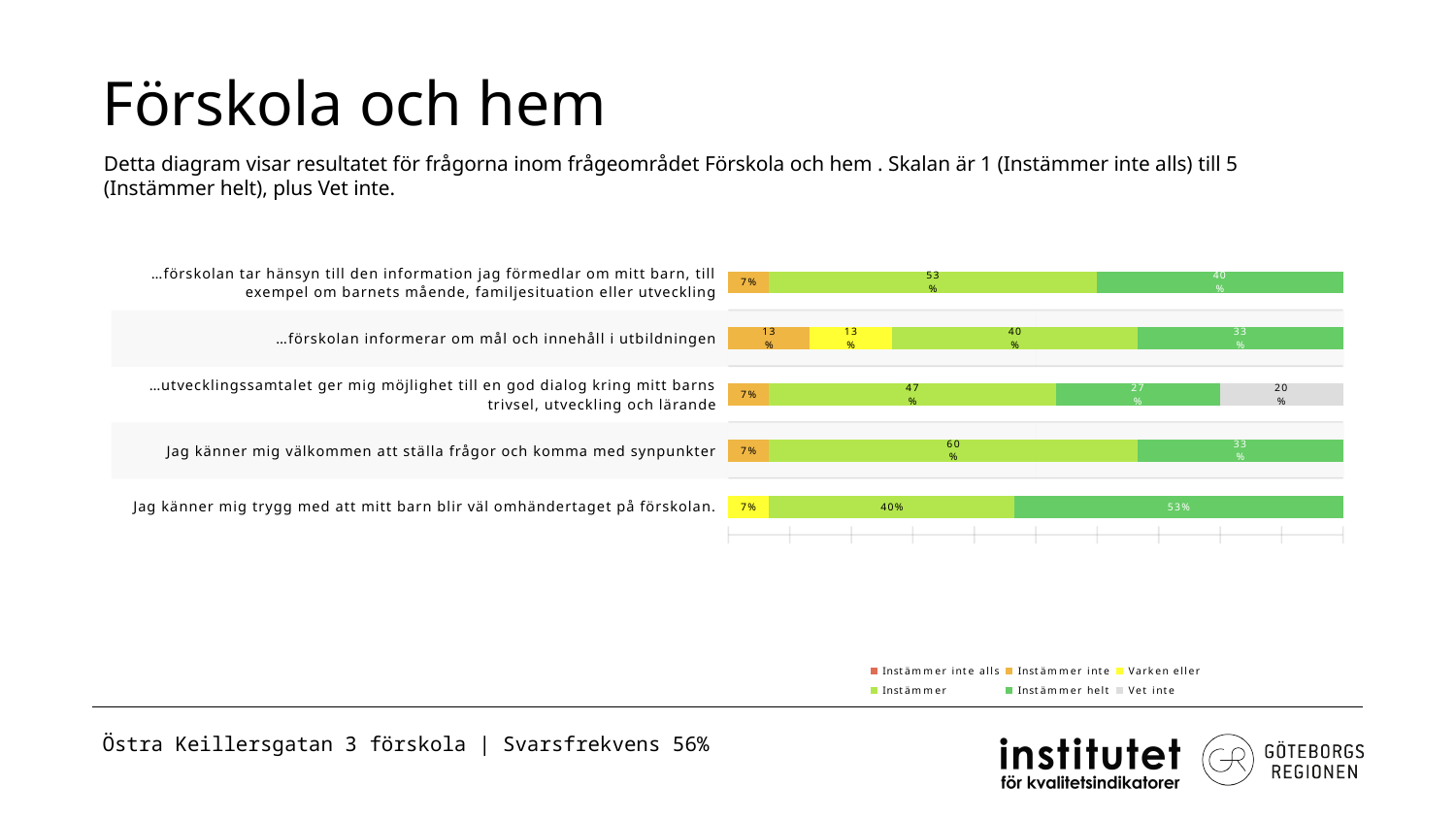
How many series does the legend list? 6 What is the 'Instämmer' value for 'Jag känner mig välkommen att ställa frågor och komma med synpunkter'? 60% What is the 'Instämmer helt' value for 'Jag känner mig trygg med att mitt barn blir väl omhändertaget på förskolan.'? 53% Which statement has the highest 'Instämmer' value? Jag känner mig välkommen att ställa frågor och komma med synpunkter What kind of chart is shown on the slide? Stacked bar chart What is the 'Vet inte' value for '…utvecklingssamtalet ger mig möjlighet till en god dialog kring mitt barns trivsel, utveckling och lärande'? 20% What is the title of the slide containing the chart? Förskola och hem How many statements (categories) are plotted in the chart? 5 What is the difference between the 'Instämmer' value and the 'Instämmer helt' value for '…förskolan tar hänsyn till den information jag förmedlar om mitt barn, till exempel om barnets mående, familjesituation eller utveckling'? 13% Which is larger: the 'Instämmer helt' value for 'Jag känner mig trygg med att mitt barn blir väl omhändertaget på förskolan.' or for '…förskolan informerar om mål och innehåll i utbildningen'? Jag känner mig trygg med att mitt barn blir väl omhändertaget på förskolan. Which statement has the lowest 'Instämmer helt' value? …utvecklingssamtalet ger mig möjlighet till en god dialog kring mitt barns trivsel, utveckling och lärande What is the 'Instämmer inte' value for '…förskolan informerar om mål och innehåll i utbildningen'? 13%